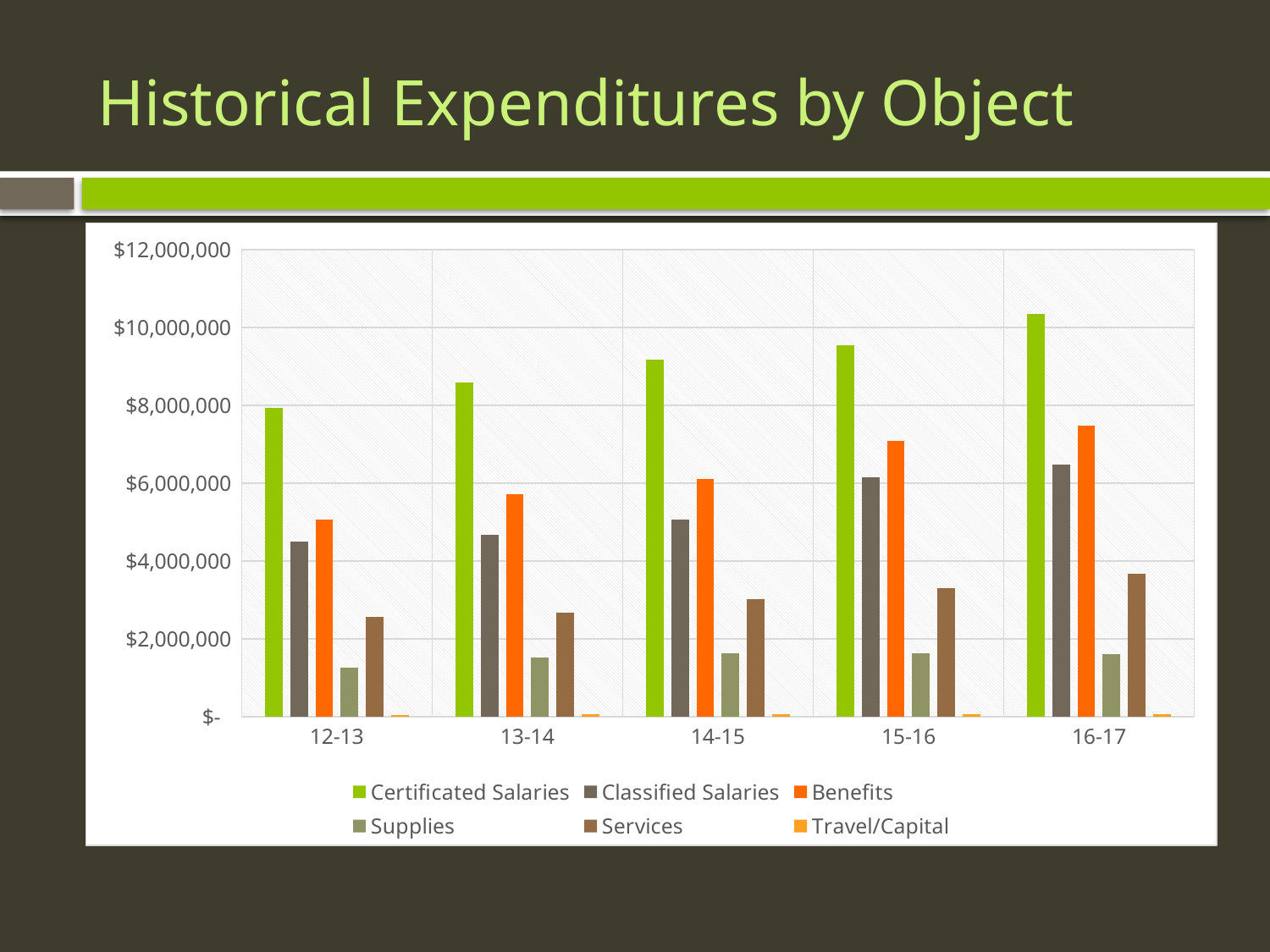
Is the value for Certificated Salaries in 16-17 greater or less than $10,000,000? greater How many year categories are shown on the x axis? 5 Which series is shown in orange in the legend? Benefits Is the value for Services in 14-15 greater or less than $4,000,000? less Is the value for Benefits in 15-16 greater or less than $6,000,000? greater What kind of chart is shown on the slide? bar chart Do the Certificated Salaries values rise or fall from 12-13 to 16-17? rise Which year has the lowest Benefits bar? 12-13 How many series does the legend list? 6 Which is larger in 13-14: Classified Salaries or Benefits? Benefits Which year has the highest Certificated Salaries bar? 16-17